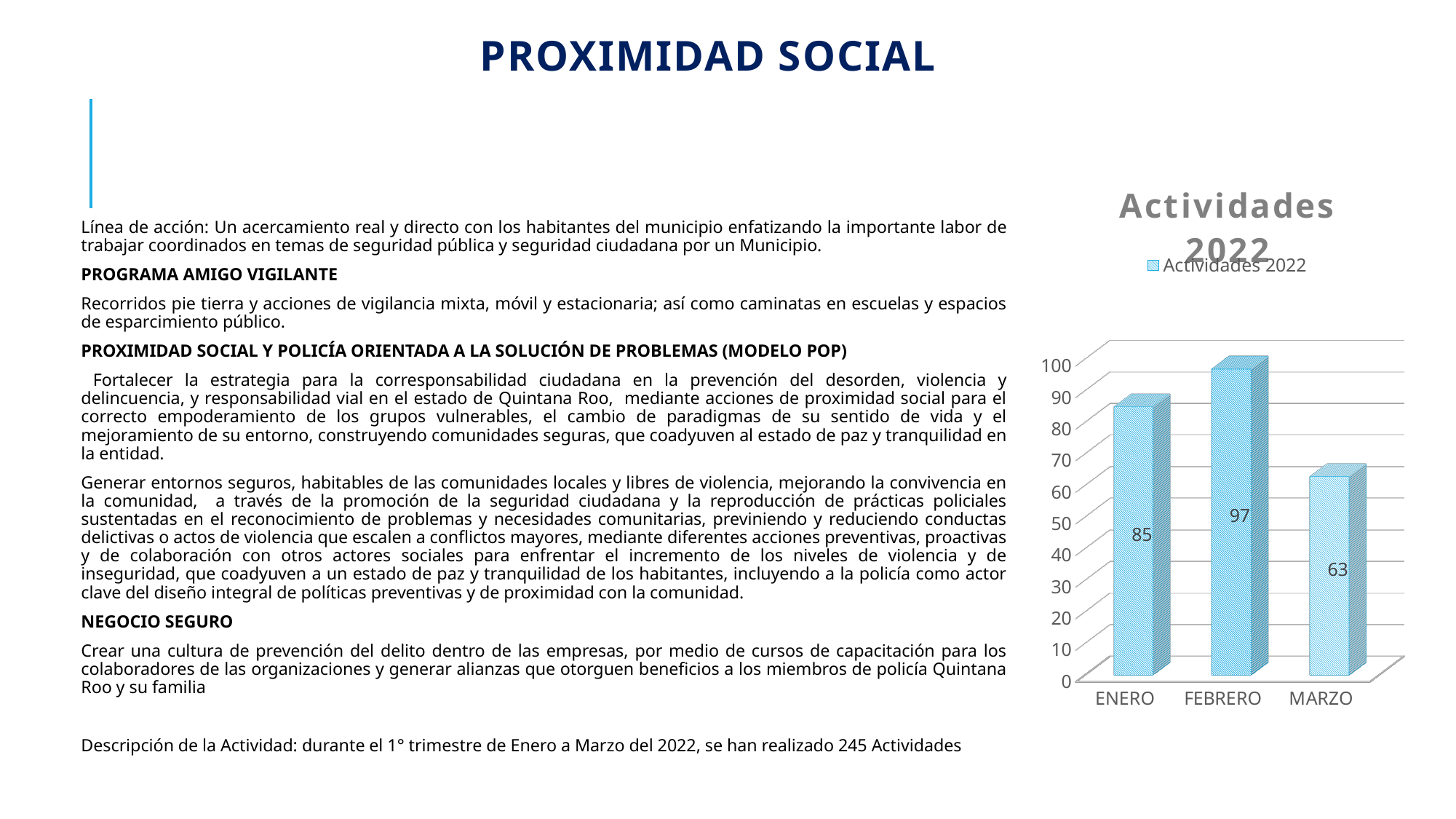
What is the value for ENERO in the Actividades 2022 chart? 85 Which is larger, the value for ENERO or the value for MARZO? ENERO Is the value for MARZO greater or less than 70? less Which month has the highest value in the Actividades 2022 chart? FEBRERO What is the difference between the values for ENERO and FEBRERO? 12 What is the value for FEBRERO in the Actividades 2022 chart? 97 Which month has the lowest value in the Actividades 2022 chart? MARZO What is the value for MARZO in the Actividades 2022 chart? 63 How many series does the chart legend list? 1 What is the difference between the values for FEBRERO and MARZO? 34 How many months are shown on the x axis of the chart? 3 What kind of chart is shown on the slide? bar chart